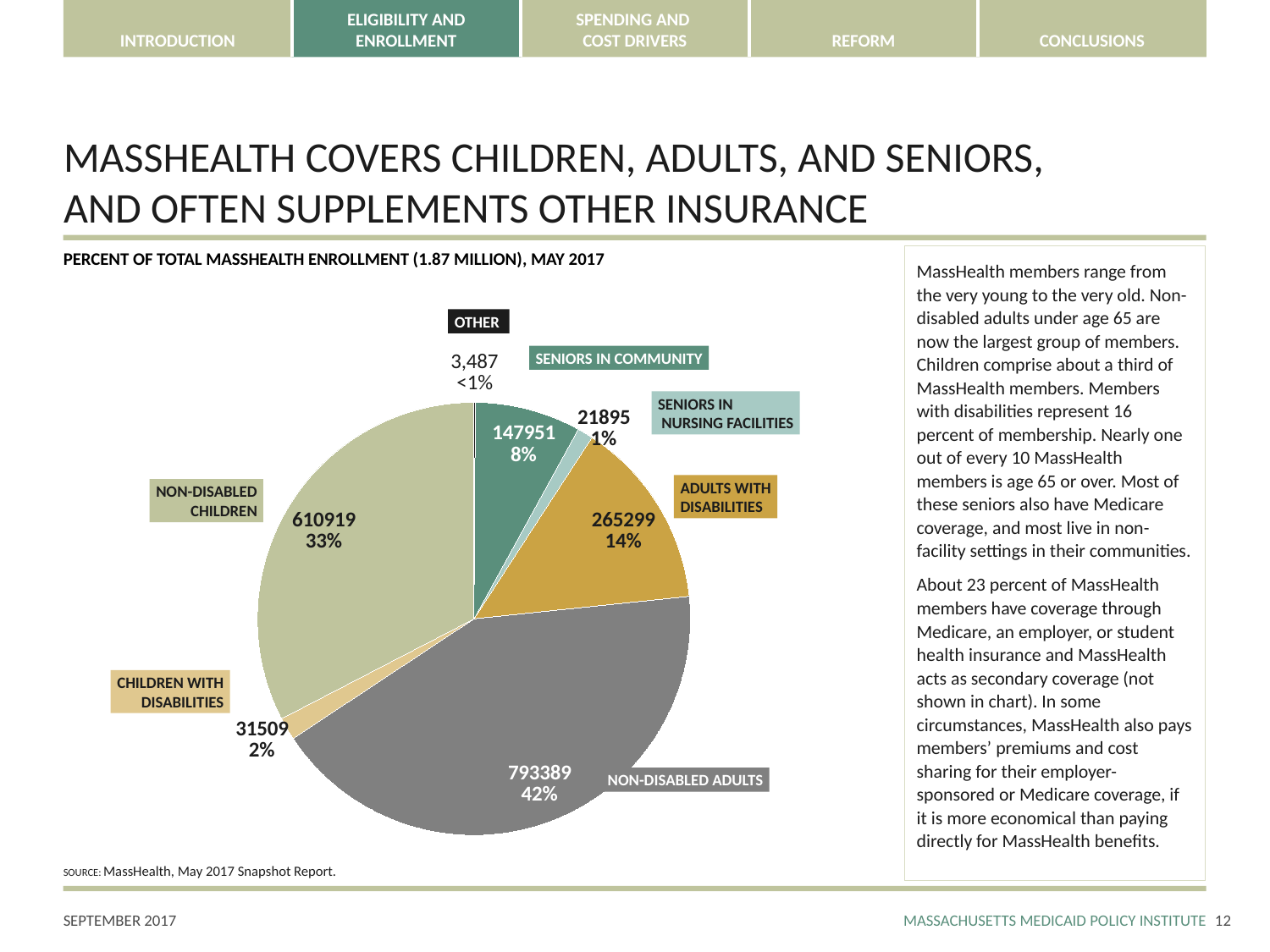
Which category has the smallest share of enrollment? Other What percent of enrollment is shown for the Other category? <1% Which is larger, the enrollment for Children with Disabilities or for Seniors in Nursing Facilities? Children with Disabilities What is the enrollment count for Seniors in Community? 147951 What percent of total MassHealth enrollment is Non-Disabled Children? 33% What percent of enrollment is Adults with Disabilities? 14% Which category has the largest share of enrollment? Non-Disabled Adults What is the title of the chart? PERCENT OF TOTAL MASSHEALTH ENROLLMENT (1.87 MILLION), MAY 2017 What is the enrollment count for Non-Disabled Adults? 793389 How many slices does the pie chart have? 7 What is the difference in enrollment between Non-Disabled Adults and Non-Disabled Children? 182470 What kind of chart is shown on the slide? Pie chart